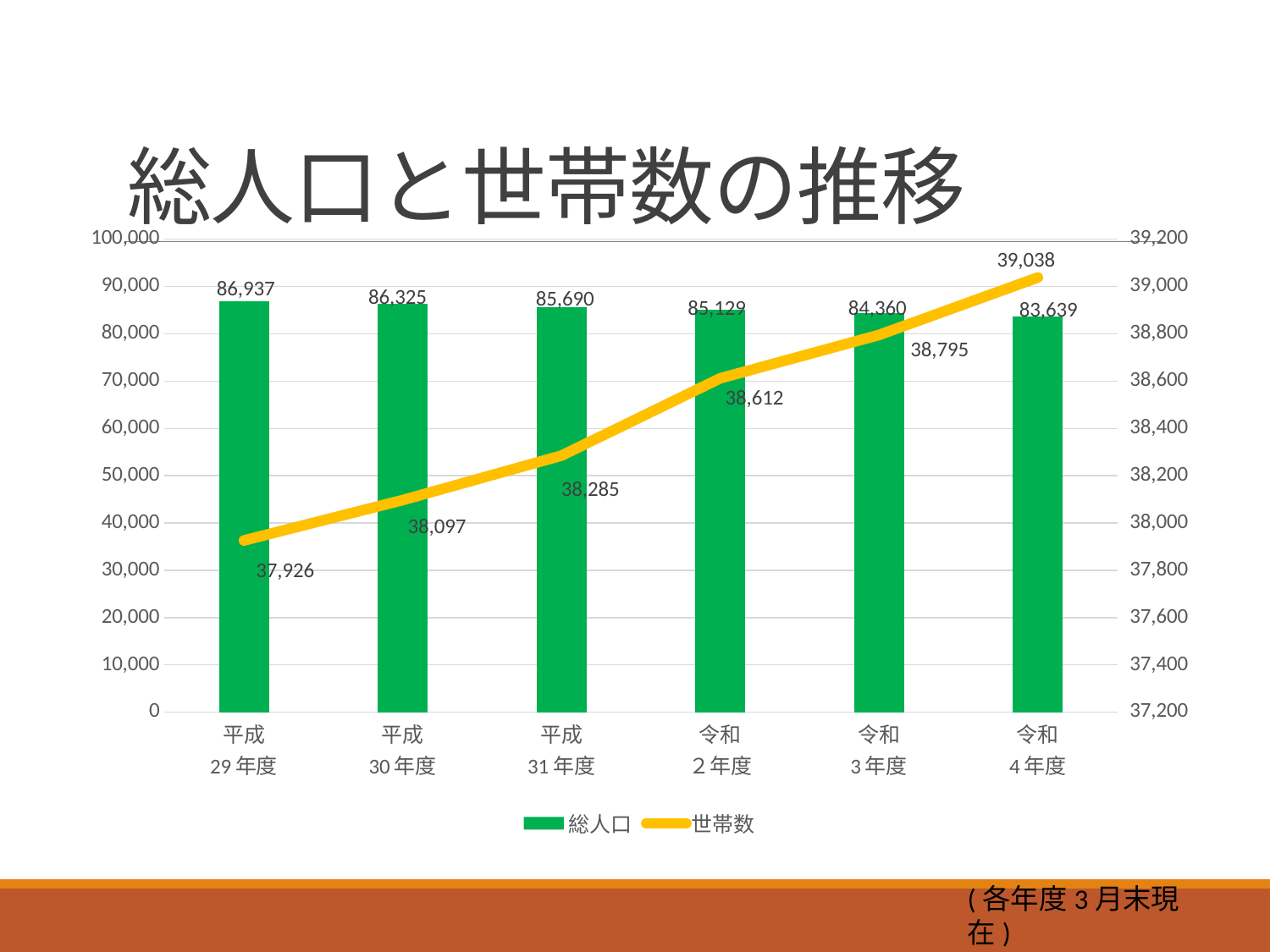
Which is larger, the 世帯数 for 令和2年度 or for 令和3年度? 令和3年度 What kind of chart is this? Combined bar and line chart What is the difference in 総人口 between 平成29年度 and 令和4年度? 3,298 What is the 総人口 value for 平成29年度? 86,937 What is the 総人口 value for 令和2年度? 85,129 How many years are shown on the x axis? 6 Which year has the lowest 世帯数? 平成29年度 What is the 世帯数 value for 平成31年度? 38,285 How many series does the legend list? 2 What is the 世帯数 value for 令和4年度? 39,038 Which year has the highest 総人口? 平成29年度 Does the 世帯数 line rise or fall from 平成29年度 to 令和4年度? Rises